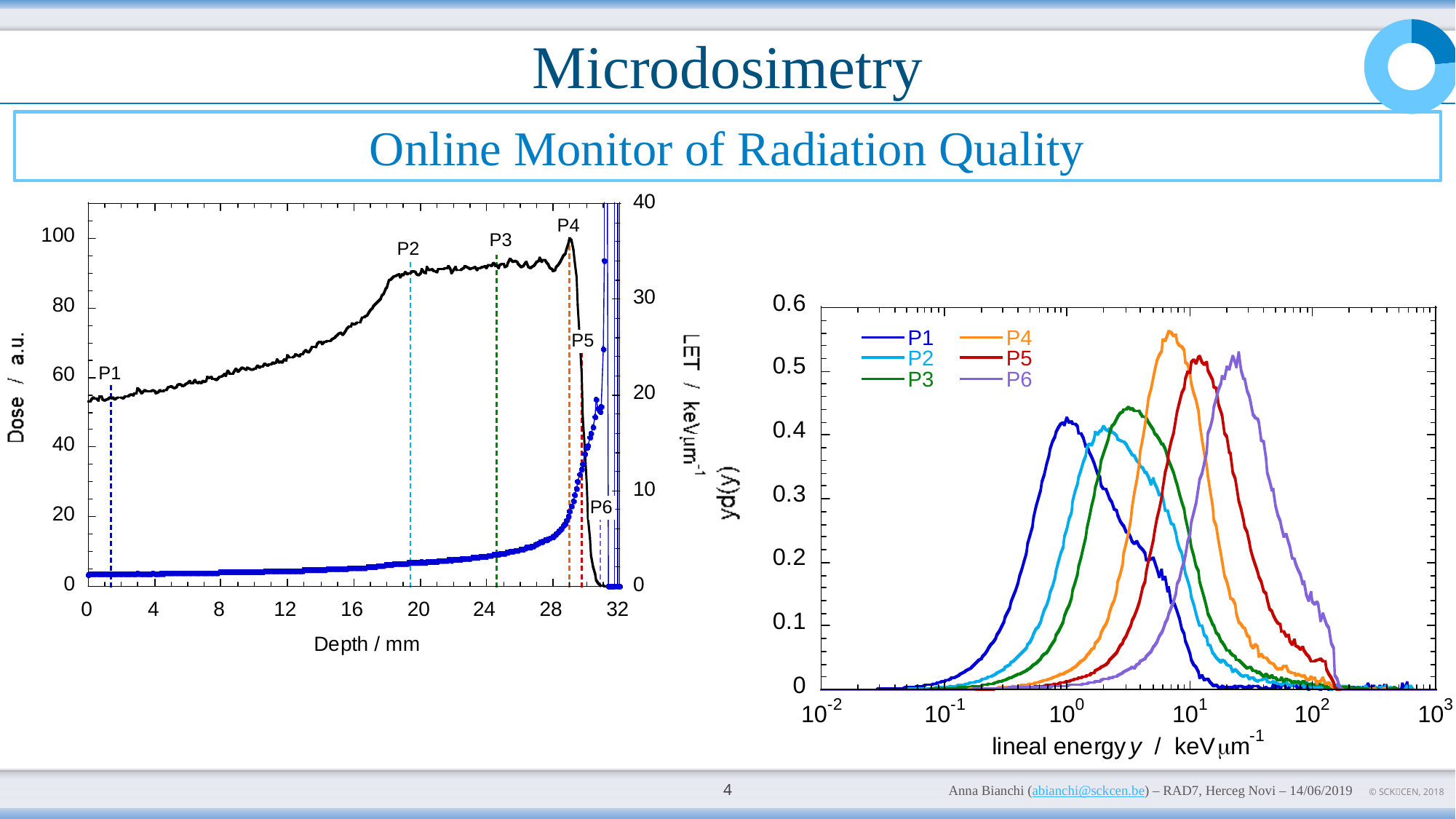
What is the x-axis label of the right-hand chart? lineal energy y / keV µm⁻¹ In the left-hand chart, does the LET curve rise or fall as depth increases from 0 to 30 mm? rise In the right-hand chart, is the peak value of P1 greater or less than 0.5? less In the right-hand chart, which series has its peak at the highest lineal energy? P6 In the left-hand chart, is the dose at P1 greater or less than 60? less In the right-hand chart, which series reaches a higher peak, P1 or P4? P4 In the right-hand chart, is the peak value of P4 greater or less than 0.5? greater What kind of chart is the right-hand chart (yd(y) versus lineal energy)? line chart In the left-hand chart, at which marked position does the dose curve reach its maximum? P4 How many series does the legend of the right-hand chart list? 6 In the right-hand chart, which series has its peak at the lowest lineal energy? P1 In the left-hand chart, how many marked positions (P1 to P6) are indicated along the depth axis? 6